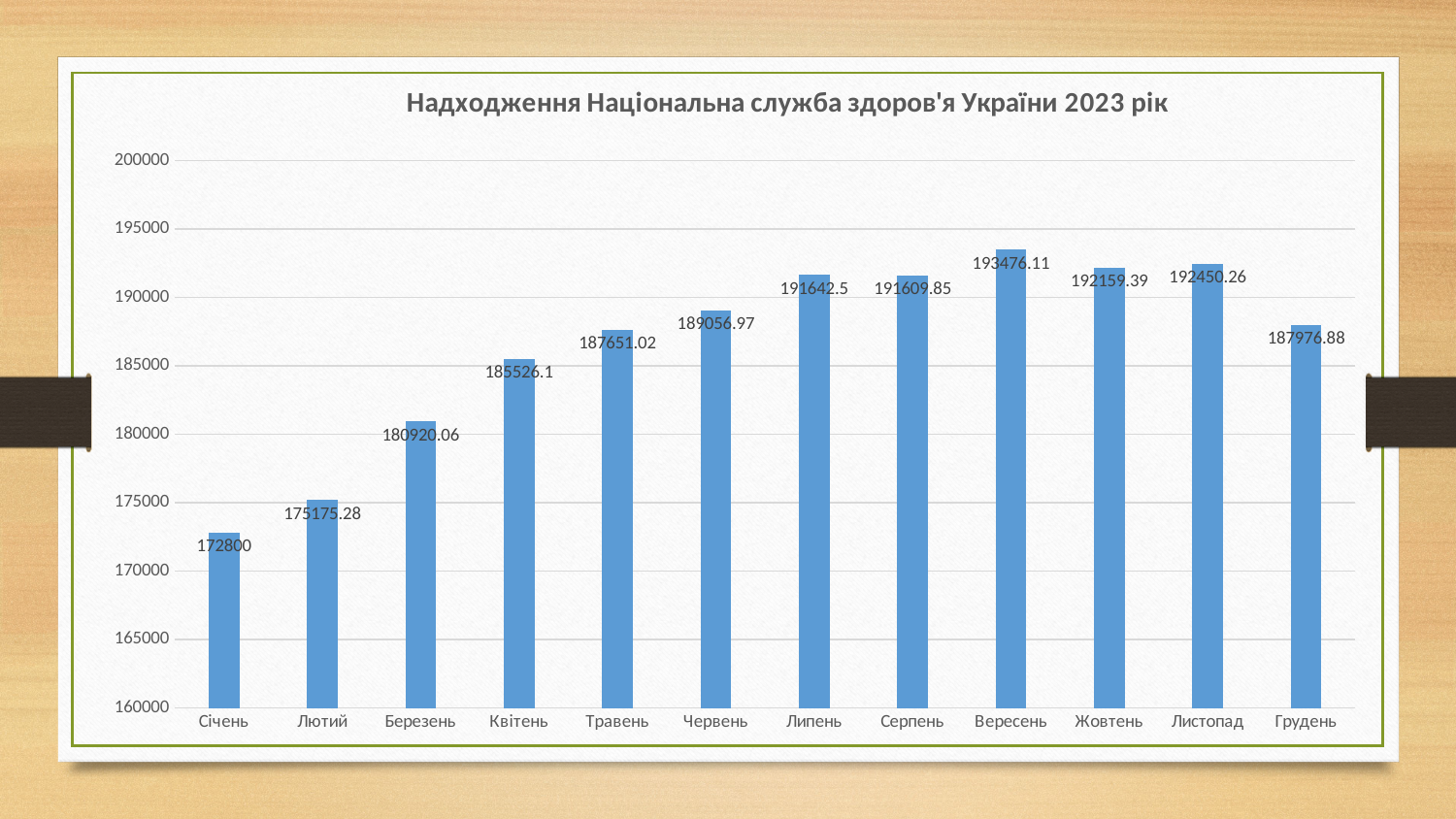
What kind of chart is shown on the slide? bar chart What is the value for Вересень? 193476.11 What is the difference between the values for Вересень and Січень? 20676.11 Which is larger, the value for Березень or the value for Травень? Травень What is the title of the chart? Надходження Національна служба здоров'я України 2023 рік How many months are shown on the x axis? 12 What is the value for Січень? 172800 Which month has the highest value? Вересень Is the value for Лютий greater or less than 180000? less What is the difference between the values for Лютий and Січень? 2375.28 Which month has the lowest value? Січень What is the value for Грудень? 187976.88